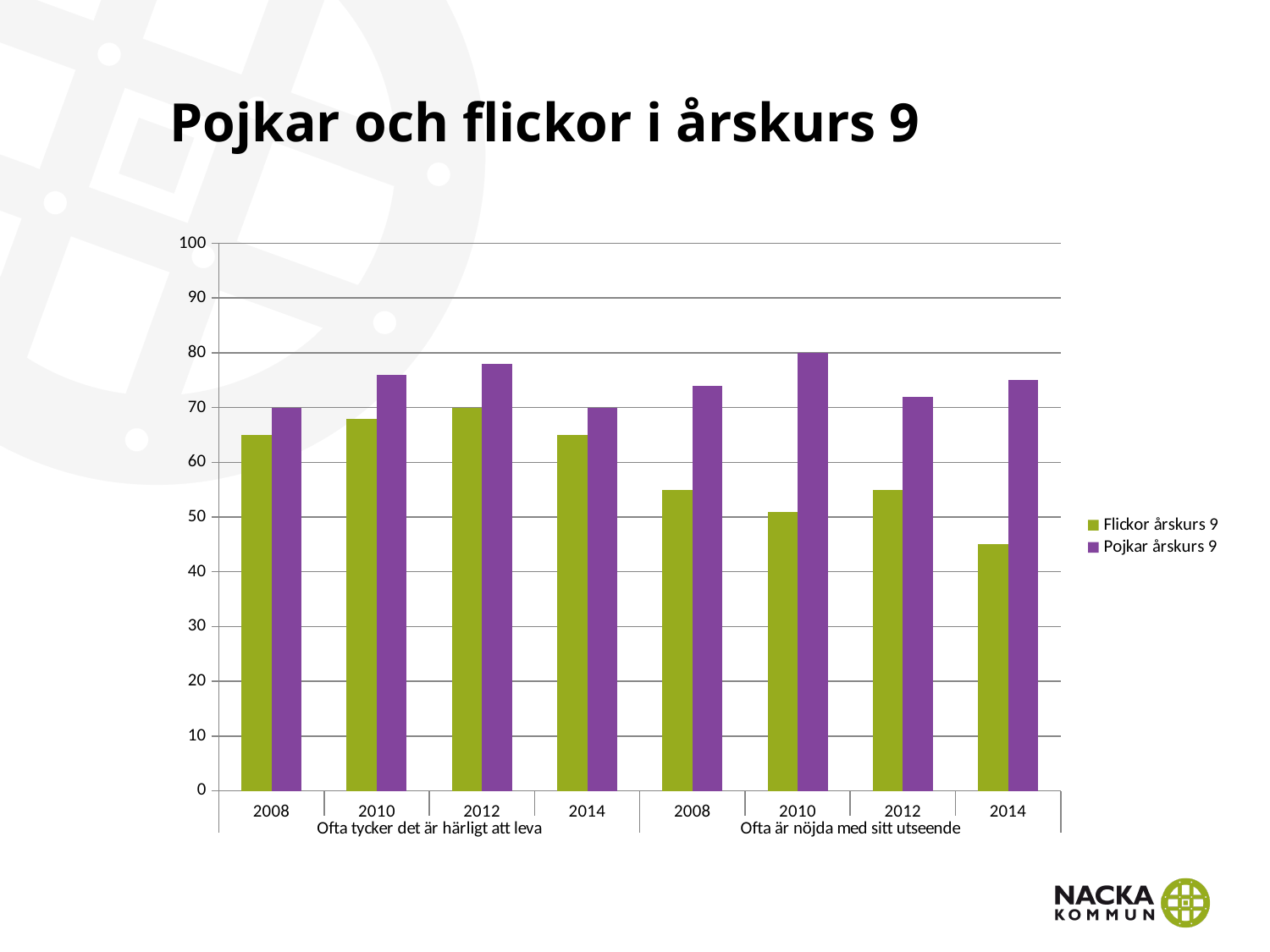
Is the value for Pojkar årskurs 9 in 2012 under 'Ofta tycker det är härligt att leva' greater or less than 70? greater In 2014 under 'Ofta är nöjda med sitt utseende', which is larger: Flickor årskurs 9 or Pojkar årskurs 9? Pojkar årskurs 9 Which bar is the lowest in the whole chart? Flickor årskurs 9, 2014, Ofta är nöjda med sitt utseende Which colour represents Pojkar årskurs 9 in the legend? purple Is the value for Flickor årskurs 9 in 2014 under 'Ofta är nöjda med sitt utseende' greater or less than 50? less Does the value for Flickor årskurs 9 under 'Ofta är nöjda med sitt utseende' rise or fall from 2012 to 2014? fall How many series does the legend list? 2 Which bar is the highest in the whole chart? Pojkar årskurs 9, 2010, Ofta är nöjda med sitt utseende What is the value for Flickor årskurs 9 in 2012 under 'Ofta tycker det är härligt att leva'? 70 What kind of chart is shown on the slide? bar chart What is the value for Pojkar årskurs 9 in 2010 under 'Ofta är nöjda med sitt utseende'? 80 How many year categories are plotted along the x axis in total? 8